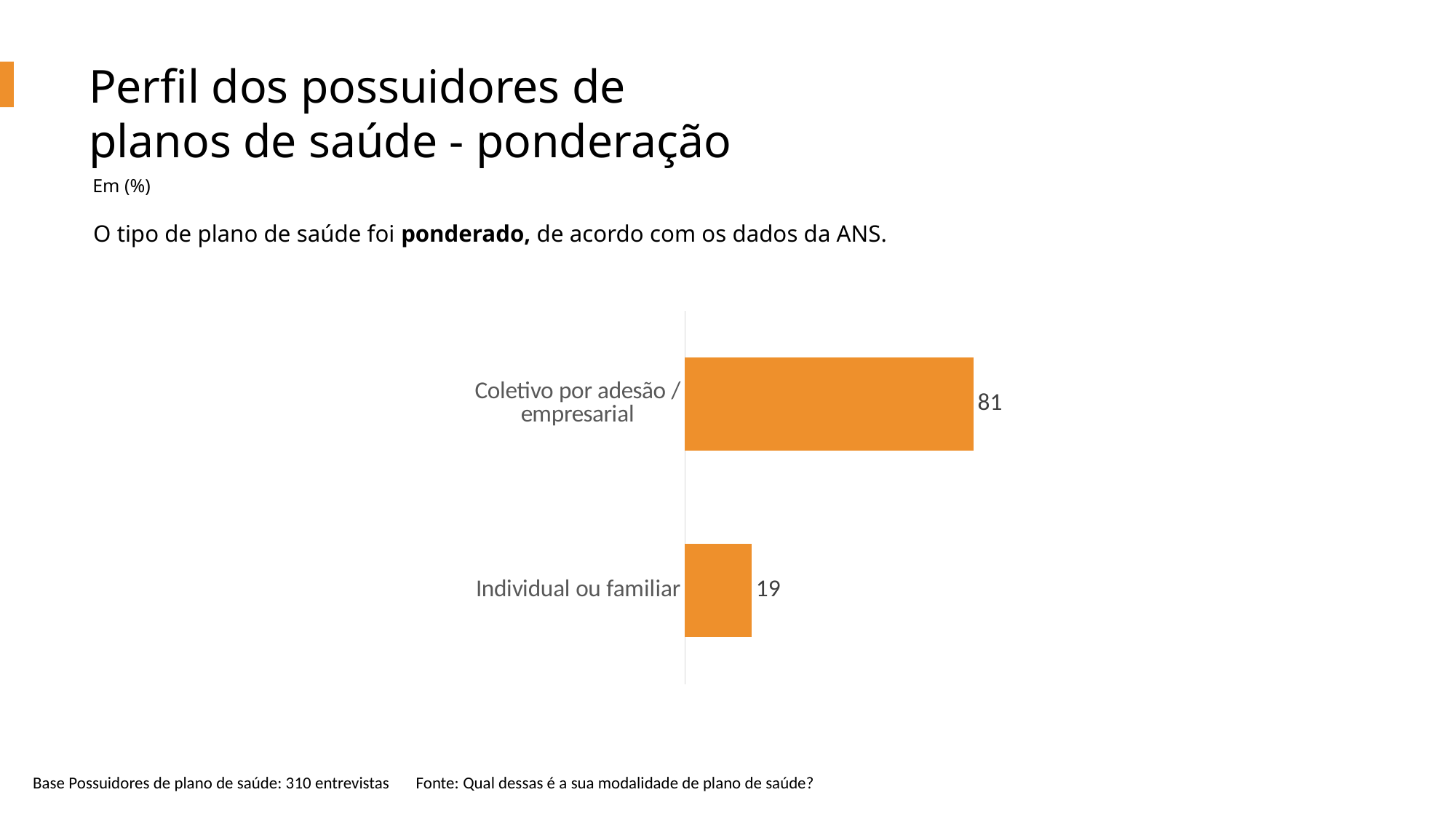
In what unit are the chart values expressed, according to the slide? % What is the value for Coletivo por adesão / empresarial? 81 Which category has the lowest value? Individual ou familiar What is the difference between the values for Coletivo por adesão / empresarial and Individual ou familiar? 62 Which category has the highest value? Coletivo por adesão / empresarial Which is larger, the value for Coletivo por adesão / empresarial or the value for Individual ou familiar? Coletivo por adesão / empresarial What is the total of the two values shown in the chart? 100 What colour are the bars in the chart? Orange How many categories are shown in the chart? 2 What kind of chart is shown on the slide? Bar chart What is the value for Individual ou familiar? 19